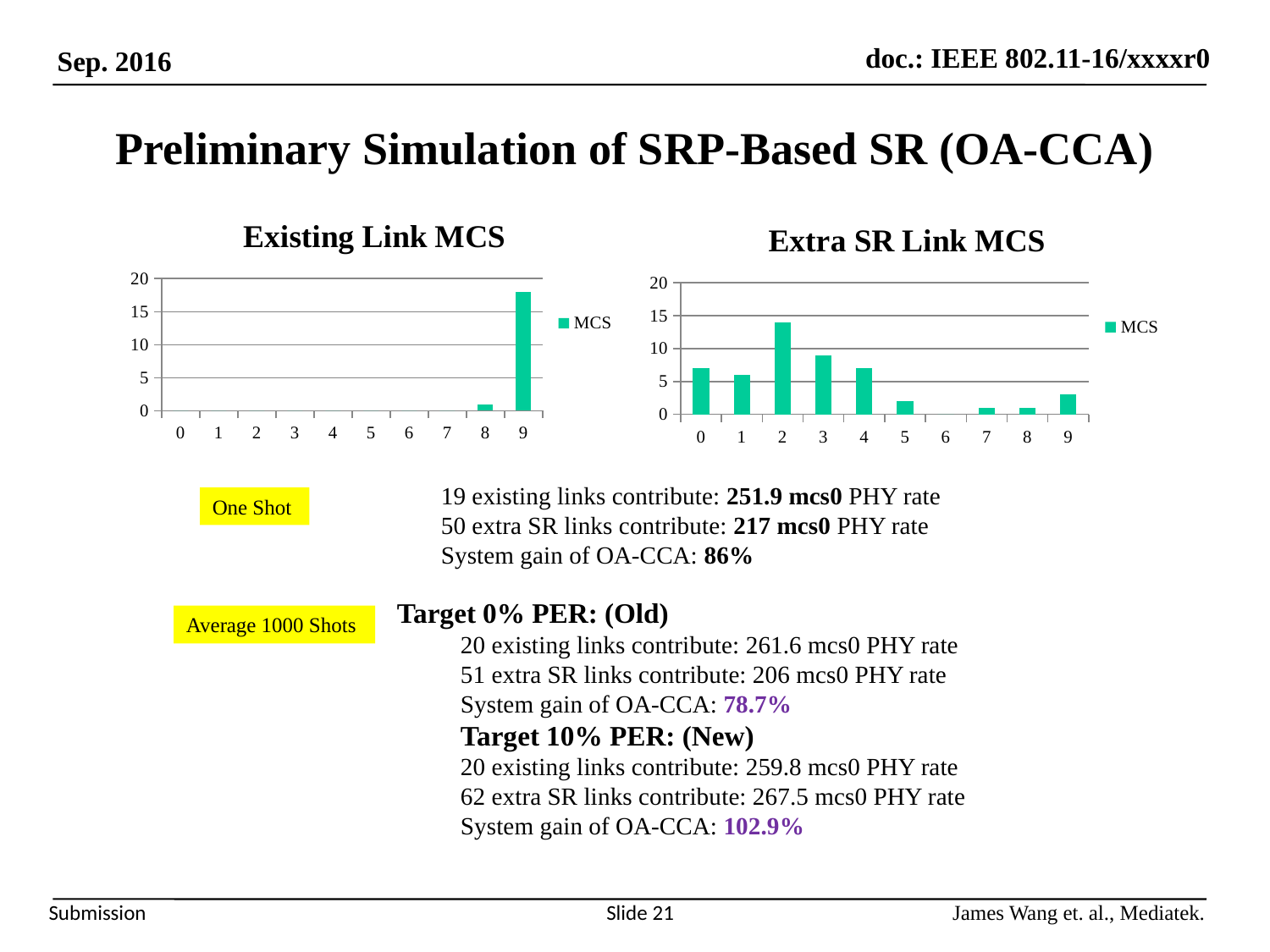
In the Existing Link MCS chart, which MCS category has the highest bar? 9 In the Extra SR Link MCS chart, which MCS category has no bar at all (the lowest value)? 6 In the Existing Link MCS chart, is the value for MCS 9 greater or less than 15? greater In the Extra SR Link MCS chart, is the value for MCS 0 greater or less than 5? greater How many MCS categories are shown on the x axis of the Extra SR Link MCS chart? 10 In the Extra SR Link MCS chart, is the value for MCS 5 greater or less than 5? less What is the legend entry shown on the Extra SR Link MCS chart? MCS In the Extra SR Link MCS chart, which MCS category has the highest bar? 2 How many series does the legend of the Existing Link MCS chart list? 1 What kind of chart is the Existing Link MCS chart? bar chart In the Extra SR Link MCS chart, which is larger, the value for MCS 2 or the value for MCS 3? MCS 2